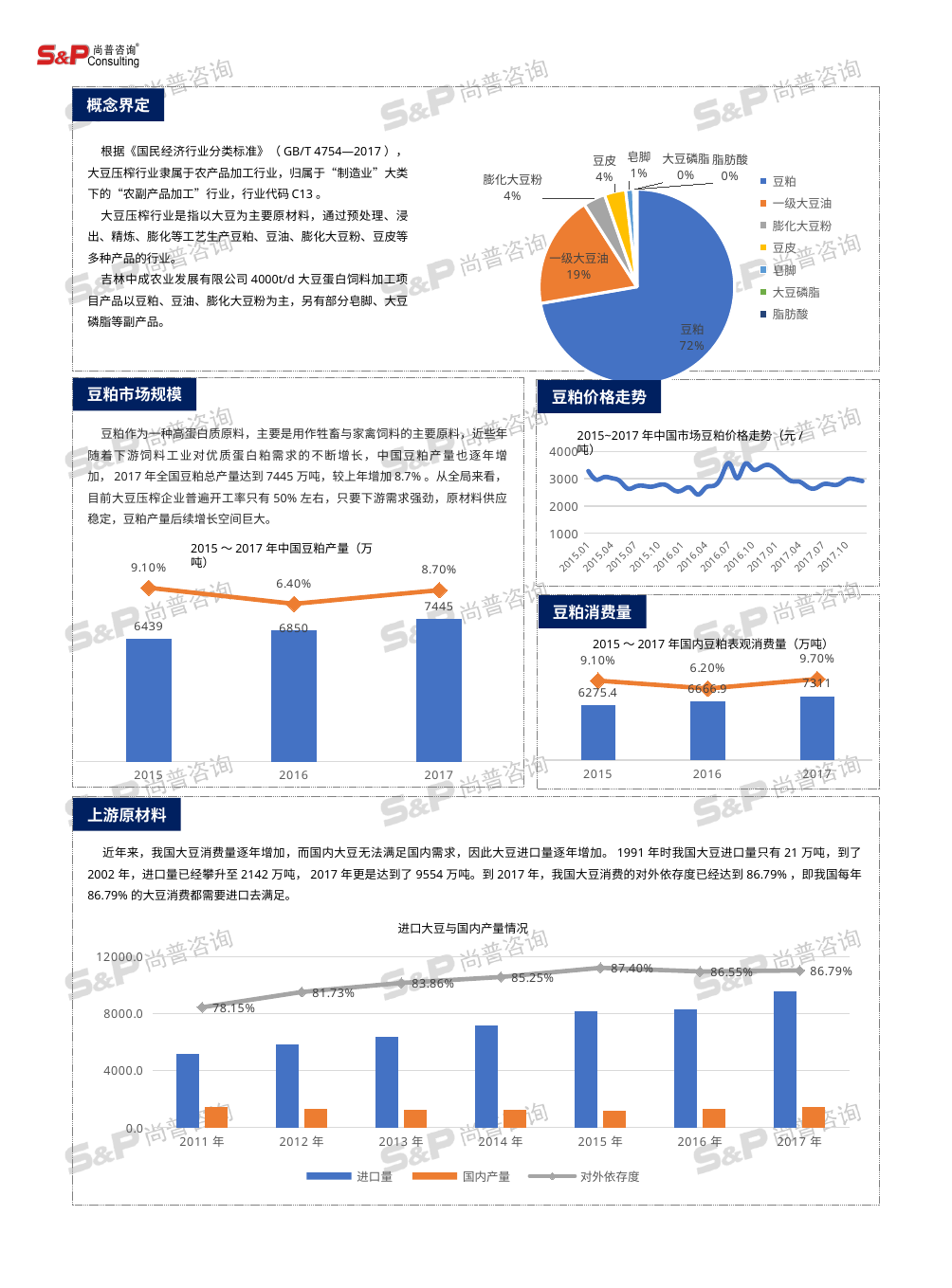
In the chart titled 2015～2017年国内豆粕表观消费量, which year has the highest growth rate? 2017 In the chart titled 2015～2017年中国豆粕产量, what growth rate is shown for 2016? 6.40% In the chart titled 进口大豆与国内产量情况, what is the 对外依存度 value for 2015年? 87.40% In the chart titled 2015～2017年中国豆粕产量, what is the difference between the 2017 and 2015 values? 1006 In the pie chart at the top right, what share does 一级大豆油 have? 19% In the chart titled 进口大豆与国内产量情况, is the 进口量 value for 2017年 greater or less than 8000.0? greater In the chart titled 进口大豆与国内产量情况, how many years are shown on the x axis? 7 How many entries does the legend of the pie chart at the top right list? 7 In the chart titled 2015～2017年中国豆粕产量, what is the value for 2017? 7445 In the pie chart at the top right, what share does 豆粕 have? 72% In the chart titled 2015～2017年国内豆粕表观消费量, what is the value for 2015? 6275.4 What kind of chart is the 2015~2017年中国市场豆粕价格走势 chart? line chart